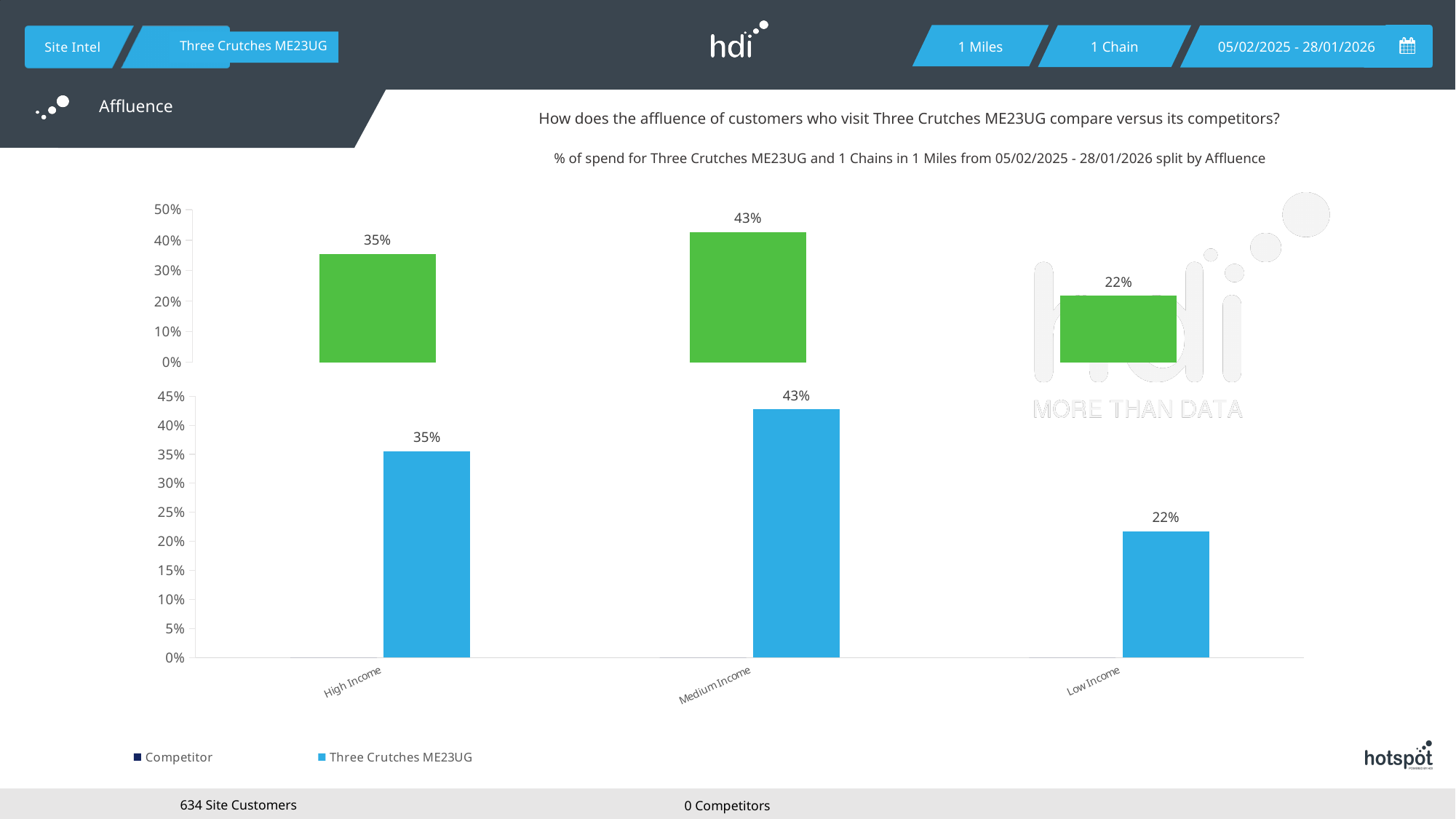
In the bottom chart, what is the value for Low Income? 22% In the bottom chart, which is larger, the value for High Income or the value for Low Income? High Income In the top chart, what is the value shown on the rightmost bar? 22% How many series does the legend at the bottom of the slide list? 2 In the bottom chart, what is the difference between the values for Medium Income and Low Income? 21% In the bottom chart, which category has the lowest value? Low Income In the bottom chart, what is the value for High Income? 35% How many categories are shown on the x axis of the bottom chart? 3 In the bottom chart, which category has the highest value? Medium Income What kind of chart is the bottom chart? bar chart In the bottom chart, what is the value for Medium Income? 43% In the top chart, what is the value shown on the middle bar? 43%